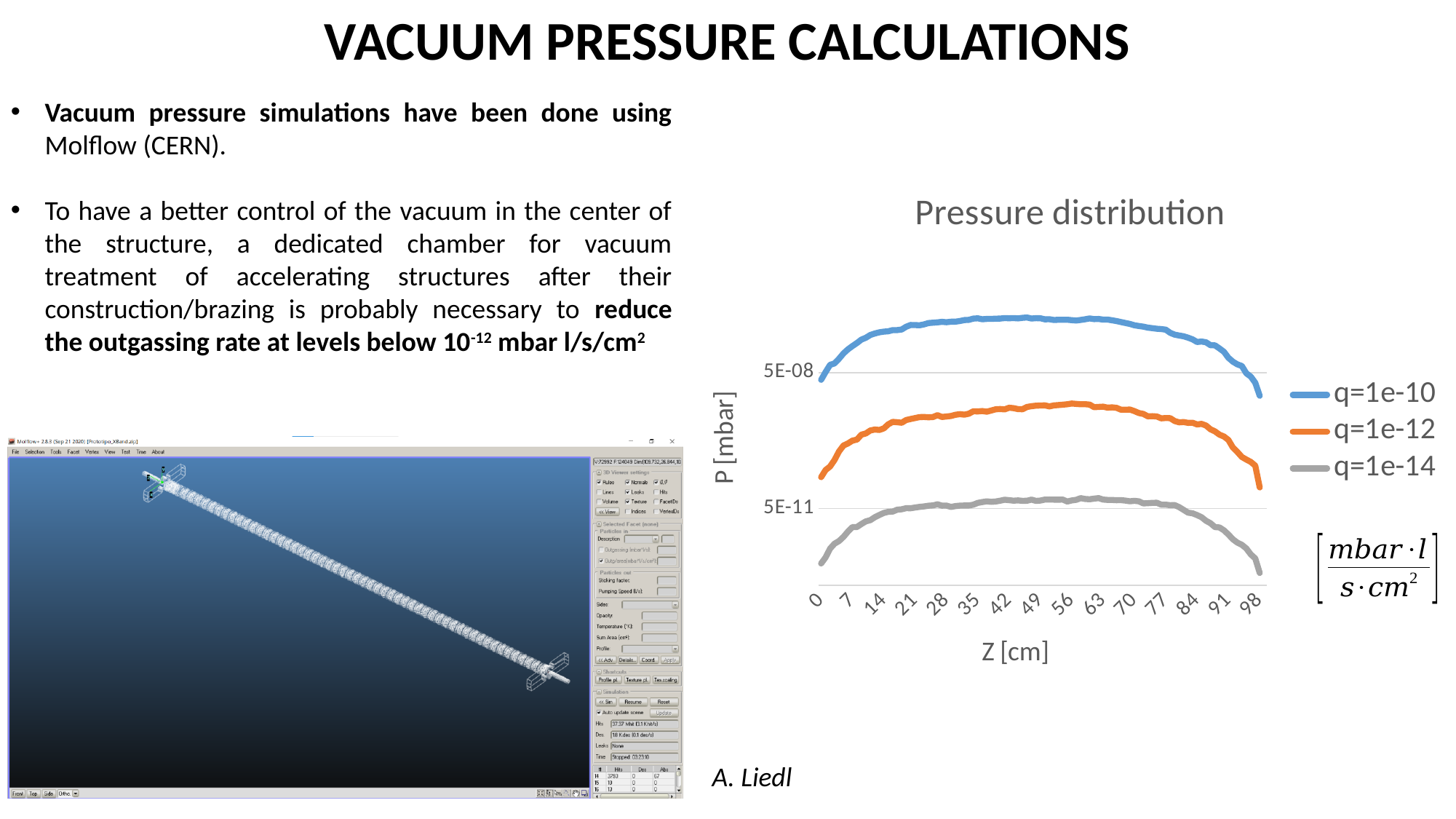
In the "Pressure distribution" chart, is the value of the q=1e-10 series at Z=49 greater or less than 5E-08? greater How many series does the legend of the "Pressure distribution" chart list? 3 What is the title of the chart on the right of the slide? Pressure distribution What is the label of the y axis of the "Pressure distribution" chart? P [mbar] In the "Pressure distribution" chart, which series has the lowest pressure values? q=1e-14 In the "Pressure distribution" chart, which series is larger at Z=49, q=1e-12 or q=1e-14? q=1e-12 In the "Pressure distribution" chart, does the q=1e-10 series rise or fall between Z=49 and Z=98? fall In the "Pressure distribution" chart, is the value of the q=1e-14 series at Z=0 greater or less than 5E-11? less In the "Pressure distribution" chart, is the value of the q=1e-12 series at Z=49 greater or less than 5E-08? less In the "Pressure distribution" chart, which series has the highest pressure values? q=1e-10 What kind of chart is the "Pressure distribution" chart? line chart